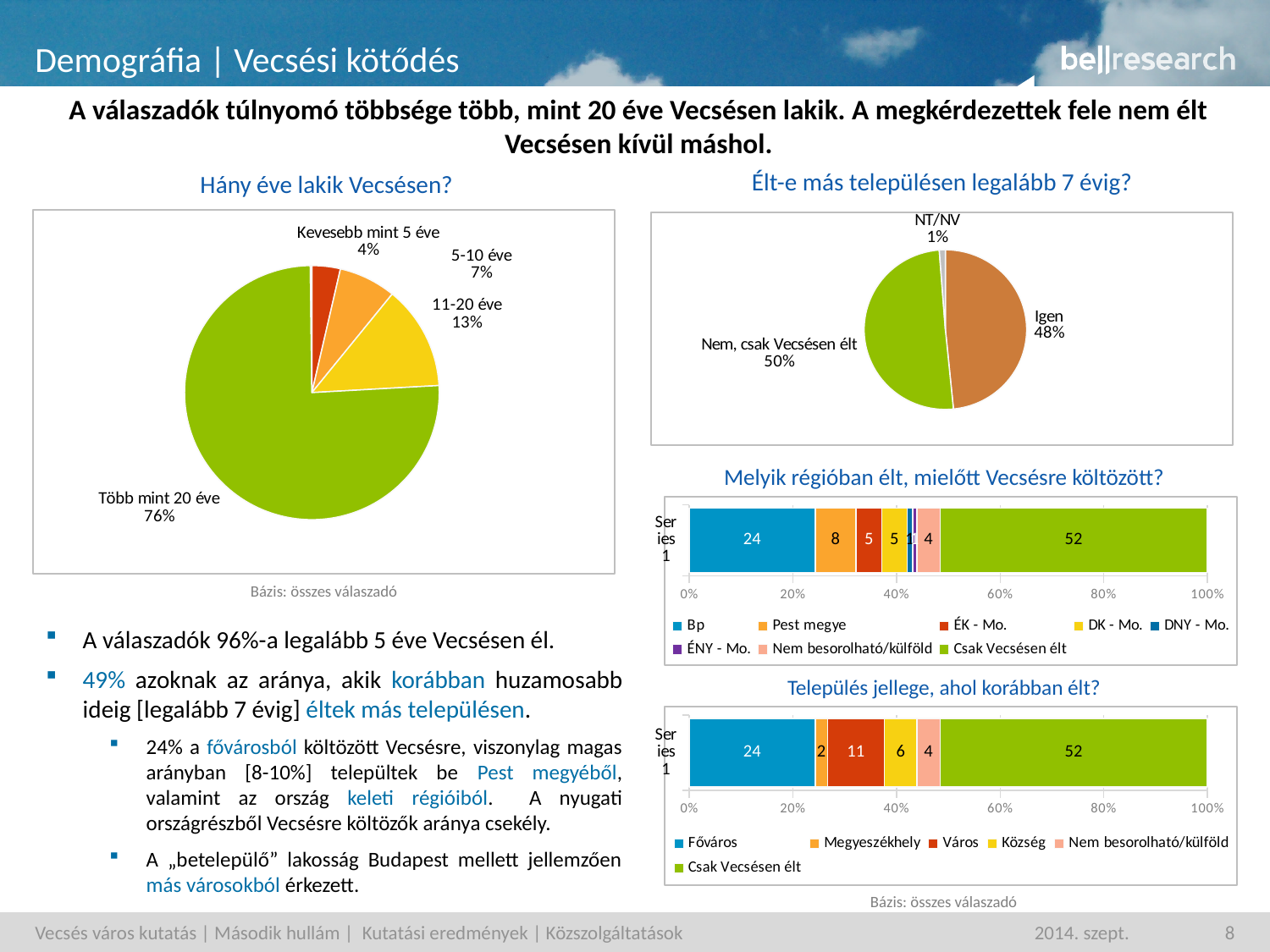
In the chart 'Élt-e más településen legalább 7 évig?', which is larger: 'Igen' or 'Nem, csak Vecsésen élt'? Nem, csak Vecsésen élt In the chart 'Hány éve lakik Vecsésen?', what is the difference in percentage points between '11-20 éve' and '5-10 éve'? 6 In the chart 'Település jellege, ahol korábban élt?', what is the value for 'Város'? 11 What type of chart is 'Élt-e más településen legalább 7 évig?'? Pie chart What type of chart is 'Település jellege, ahol korábban élt?'? Stacked bar chart In the chart 'Hány éve lakik Vecsésen?', what share of respondents have lived in Vecsés for more than 20 years (Több mint 20 éve)? 76% In the chart 'Hány éve lakik Vecsésen?', how many slices does the pie have? 4 In the chart 'Élt-e más településen legalább 7 évig?', what share answered 'Igen'? 48% In the chart 'Melyik régióban élt, mielőtt Vecsésre költözött?', which series has the largest segment? Csak Vecsésen élt In the chart 'Melyik régióban élt, mielőtt Vecsésre költözött?', how many series does the legend list? 8 In the chart 'Melyik régióban élt, mielőtt Vecsésre költözött?', what is the value for 'Bp'? 24 In the chart 'Hány éve lakik Vecsésen?', which category has the smallest share? Kevesebb mint 5 éve